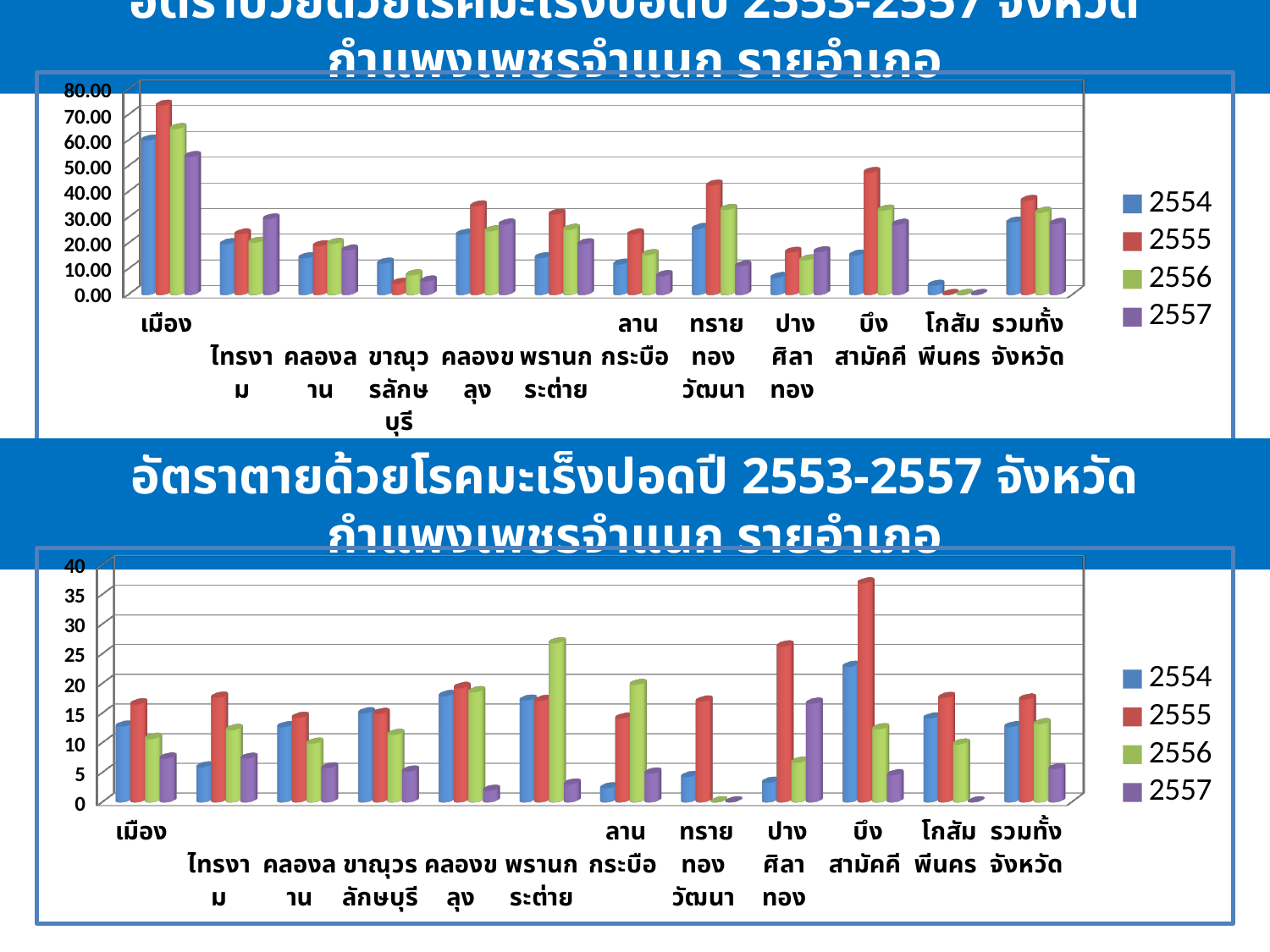
In the bottom chart, which district has the highest 2556 bar? พรานกระต่าย In the top chart, is the 2555 value for โกสัมพีนคร greater or less than 10.00? less In the bottom chart, for ทรายทองวัฒนา, which is larger: the 2555 value or the 2556 value? 2555 In the top chart, which district has the highest 2555 bar? เมือง Which legend entry is shown in red in the bottom chart? 2555 In the top chart, is the 2555 value for บึงสามัคคี greater or less than 40.00? greater What kind of chart is the top chart on the slide? bar chart In the top chart, is the 2554 value for เมือง greater or less than 50.00? greater In the bottom chart, which district has the highest 2555 bar? บึงสามัคคี How many series does the legend of the bottom chart list? 4 How many districts (categories) are shown on the x axis of the bottom chart? 12